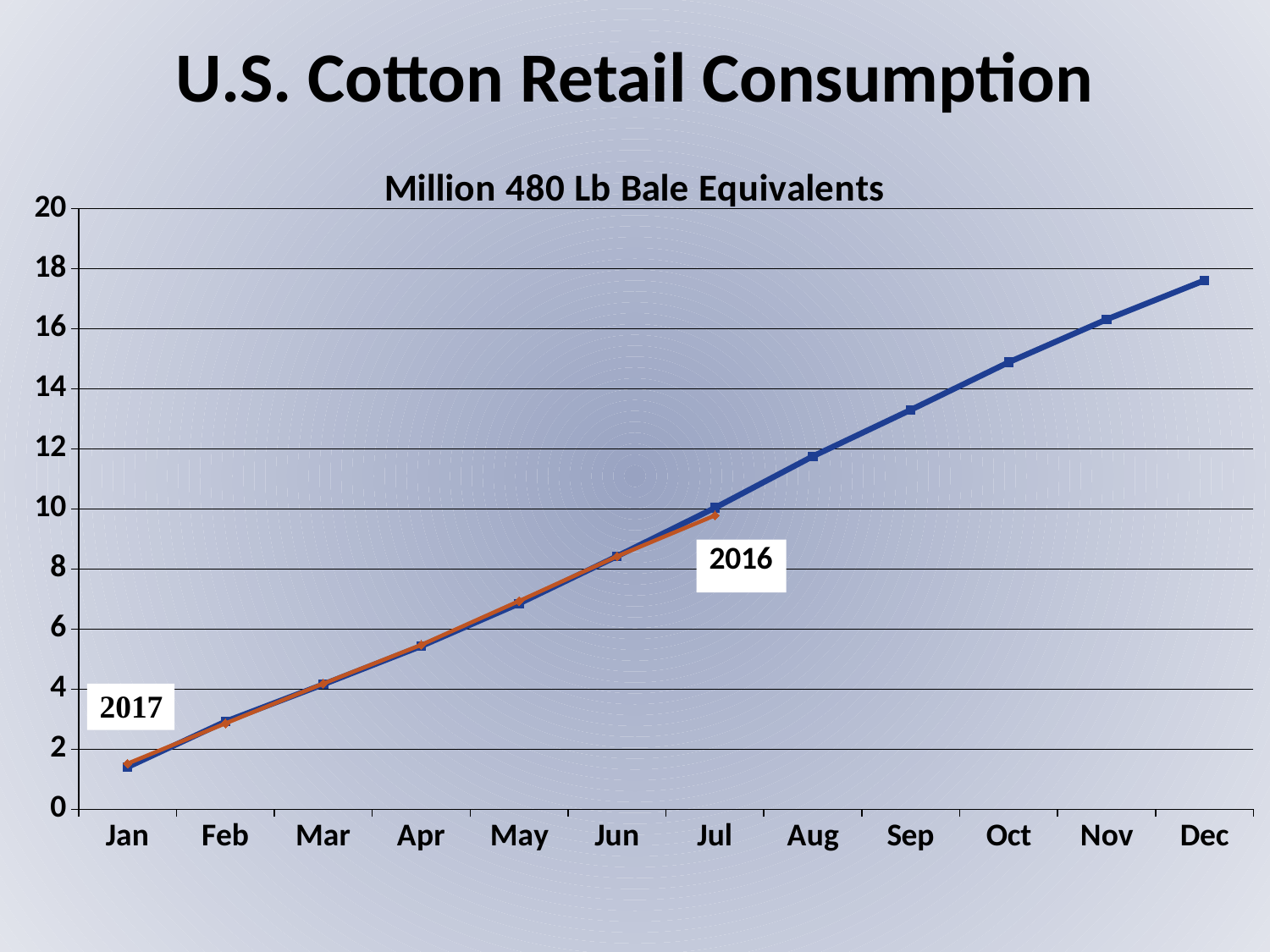
Is the value for 2016 in Dec greater or less than 16? greater In which month is the 2016 series highest? Dec In which month is the 2016 series lowest? Jan Do the values for the 2016 series rise or fall from Jan to Dec? rise Which years are labelled as series on the chart? 2016 and 2017 Is the value for 2016 in Sep greater or less than 12? greater Through which month does the 2017 series extend? Jul What kind of chart is shown on the slide? line chart How many months are shown on the x axis? 12 How many data series are plotted on the chart? 2 Is the value for 2017 in Apr greater or less than 6? less What is the subtitle shown above the chart area? Million 480 Lb Bale Equivalents